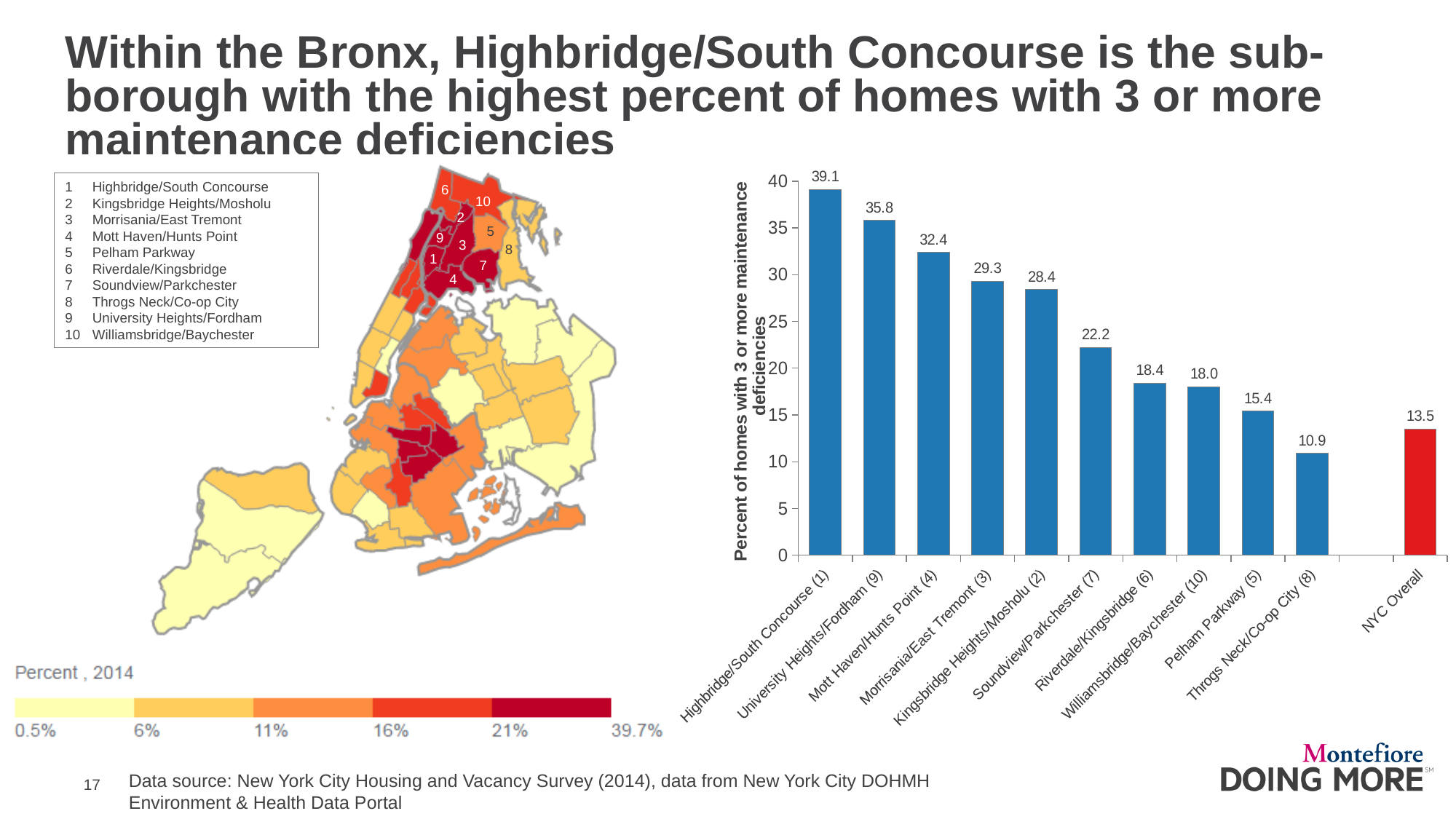
On the bar chart, what is the value for NYC Overall? 13.5 On the bar chart, what colour is the NYC Overall bar? red What kind of chart is shown on the right side of the slide? bar chart How many bars are shown on the bar chart? 11 On the bar chart, which category has the highest value? Highbridge/South Concourse (1) On the bar chart, what is the value for Soundview/Parkchester (7)? 22.2 On the bar chart, what is the percent of homes with 3 or more maintenance deficiencies for Highbridge/South Concourse (1)? 39.1 On the bar chart, what is the difference between the values for Highbridge/South Concourse (1) and University Heights/Fordham (9)? 3.3 On the bar chart, what is the difference between the value for Highbridge/South Concourse (1) and NYC Overall? 25.6 On the bar chart, which is larger: the value for Riverdale/Kingsbridge (6) or Williamsbridge/Baychester (10)? Riverdale/Kingsbridge (6) On the bar chart, is the value for Pelham Parkway (5) greater or less than 20? less On the bar chart, which sub-borough has the lowest percent of homes with 3 or more maintenance deficiencies? Throgs Neck/Co-op City (8)